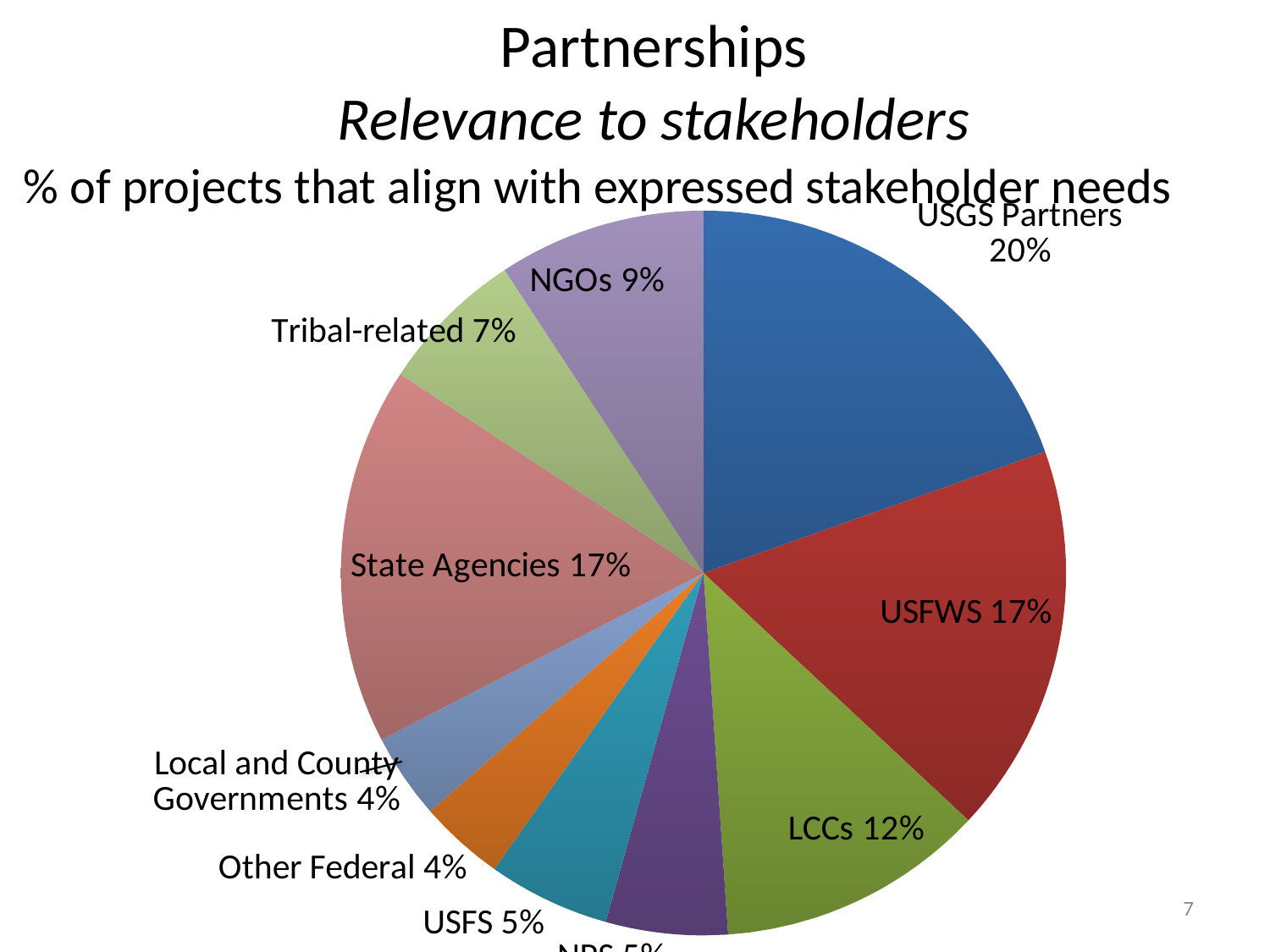
What is the value shown for Tribal-related? 7% What is the value shown for LCCs? 12% What is the value shown for State Agencies? 17% Which category has the largest slice of the pie? USGS Partners What is the difference between the USGS Partners value and the LCCs value? 8% What is the subtitle text describing what the chart measures? % of projects that align with expressed stakeholder needs What kind of chart is shown on the slide? pie chart What percentage of projects align with USGS Partners? 20% What is the value shown for NGOs? 9% Which is larger, the value for NGOs or the value for Tribal-related? NGOs What is the value shown for USFWS? 17% How many slices does the pie chart have? 10